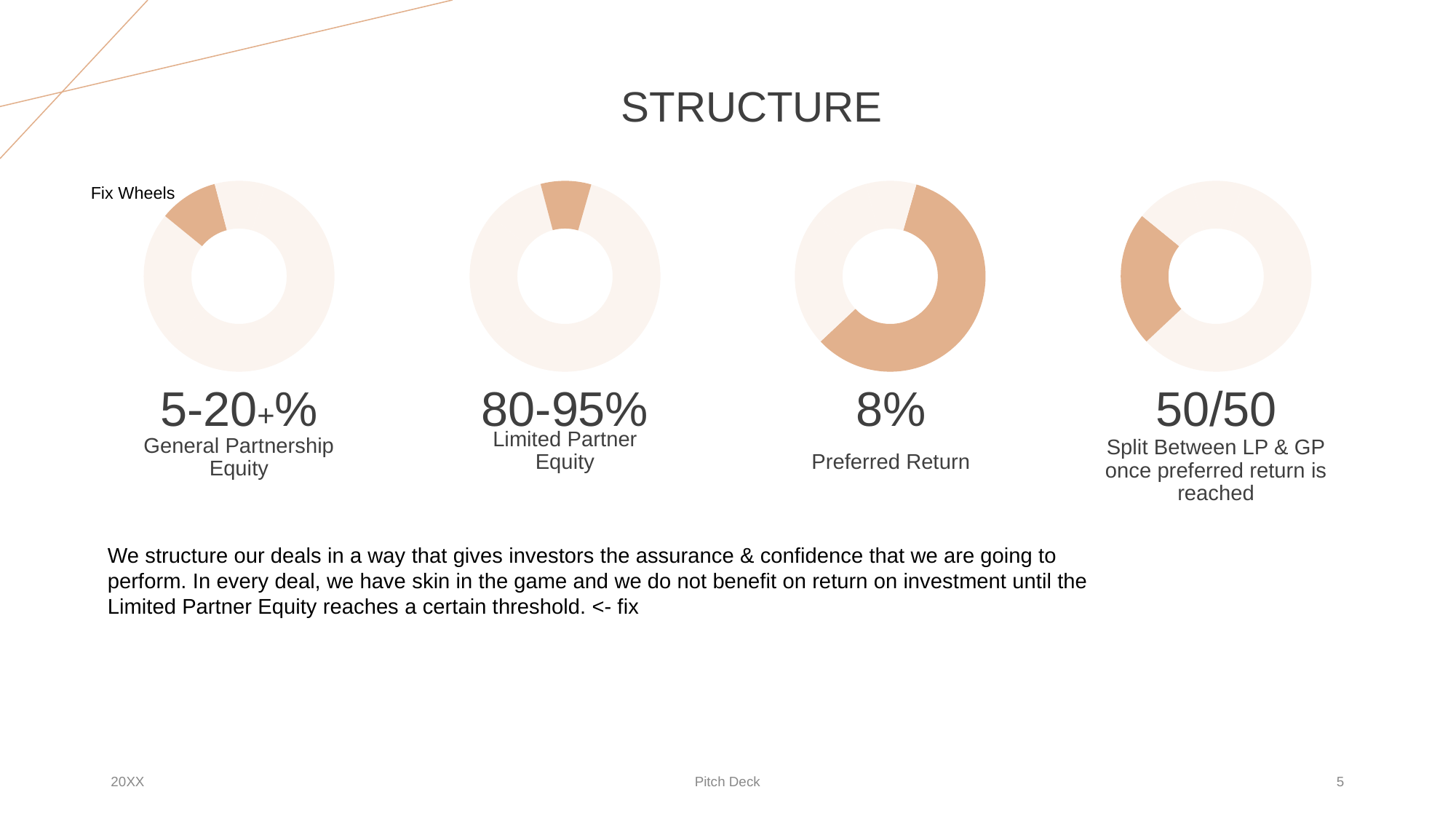
What is the title of the slide containing the four donut charts? STRUCTURE What value is printed under the first donut chart, labelled General Partnership Equity? 5-20+% What value is printed under the second donut chart, labelled Limited Partner Equity? 80-95% Which donut chart on the slide has the smallest shaded (darker) portion? The second chart (Limited Partner Equity) What label appears under the third donut chart? Preferred Return Which donut chart on the slide has the largest shaded (darker) portion? The third chart (Preferred Return) What value is printed under the fourth donut chart, for the split between LP & GP once preferred return is reached? 50/50 What value is printed under the third donut chart, labelled Preferred Return? 8% How many donut charts are on the slide? 4 What kind of charts are shown on the slide? Donut (pie) charts Is the shaded portion of the first donut chart (General Partnership Equity) larger or smaller than the shaded portion of the third donut chart (Preferred Return)? smaller